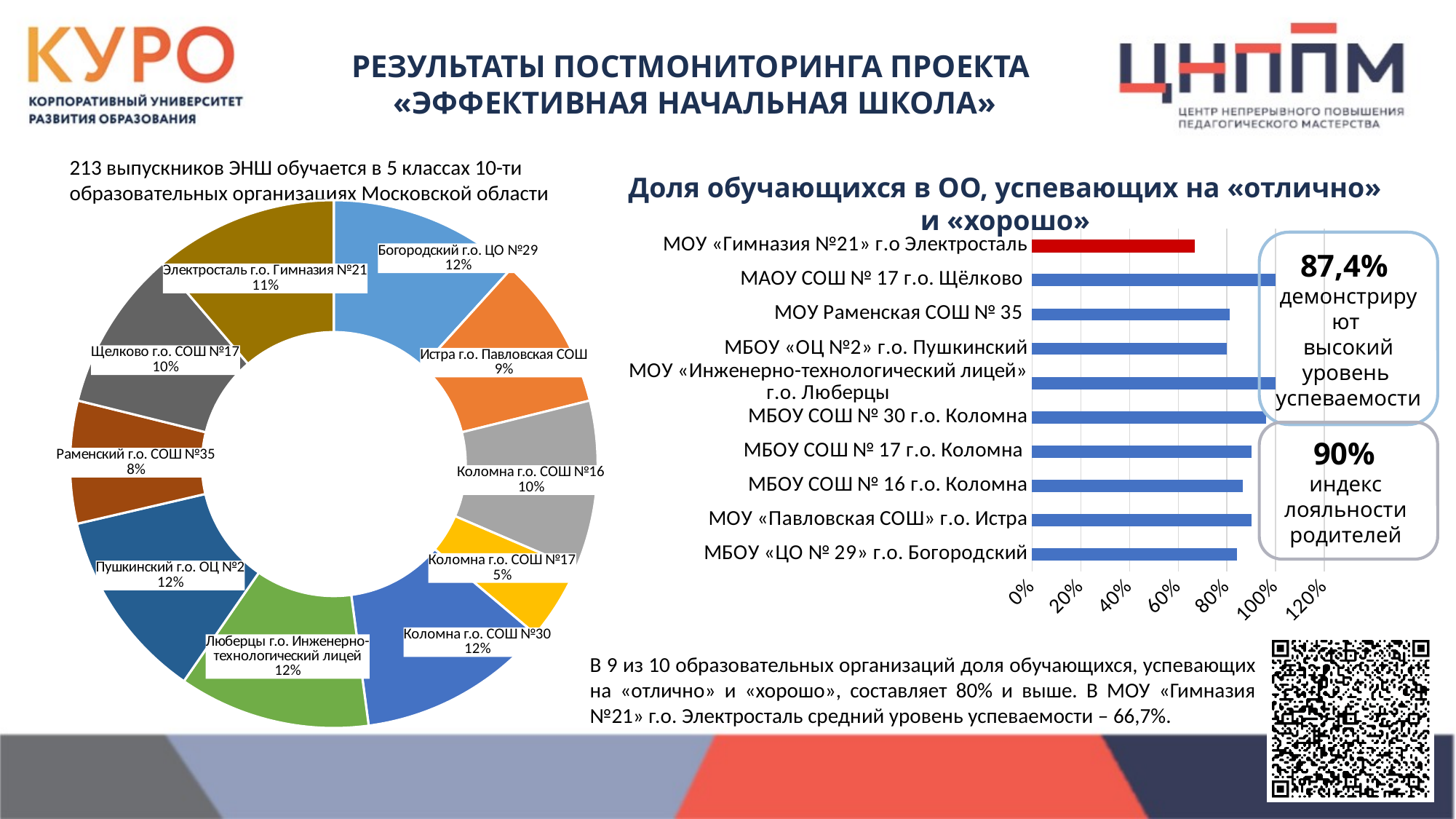
What kind of chart is the chart on the left of the slide? Doughnut chart What kind of chart is the chart titled «Доля обучающихся в ОО, успевающих на «отлично» и «хорошо»»? Bar chart On the bar chart «Доля обучающихся в ОО, успевающих на «отлично» и «хорошо»», is the value for МБОУ СОШ № 30 г.о. Коломна greater or less than 80%? greater On the pie chart on the left, what is the difference between the shares of Богородский г.о. ЦО №29 and Коломна г.о. СОШ №17? 7% On the pie chart on the left, which has the larger share: Электросталь г.о. Гимназия №21 or Раменский г.о. СОШ №35? Электросталь г.о. Гимназия №21 On the bar chart «Доля обучающихся в ОО, успевающих на «отлично» и «хорошо»», is the value for МОУ «Гимназия №21» г.о Электросталь greater or less than 80%? less On the pie chart on the left, what share is shown for Коломна г.о. СОШ №17? 5% How many categories does the pie chart on the left show? 10 On the pie chart on the left, what share is shown for Электросталь г.о. Гимназия №21? 11% On the pie chart on the left, which category has the smallest share? Коломна г.о. СОШ №17 On the bar chart «Доля обучающихся в ОО, успевающих на «отлично» и «хорошо»», which organisation has the lowest value? МОУ «Гимназия №21» г.о Электросталь On the pie chart on the left, what share is shown for Раменский г.о. СОШ №35? 8%